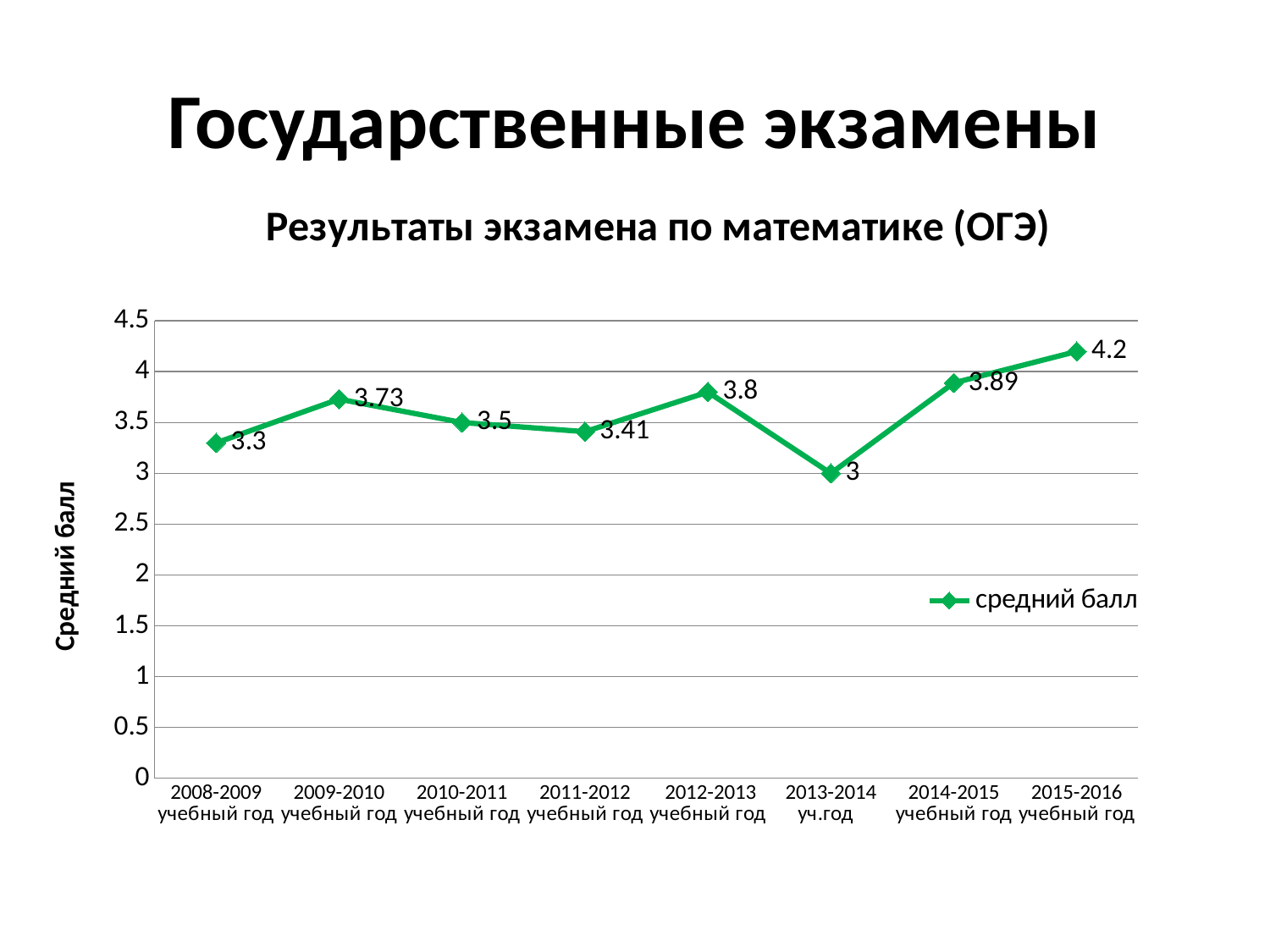
What is the average score for 2013-2014 уч.год? 3 How many series does the legend list? 1 What kind of chart is shown on the slide? line chart Is the value for 2014-2015 учебный год greater or less than 3.5? greater Which is larger: the average score for 2009-2010 учебный год or 2011-2012 учебный год? 2009-2010 учебный год What is the average score for 2015-2016 учебный год? 4.2 What is the title of the chart? Результаты экзамена по математике (ОГЭ) How many academic years are plotted on the chart? 8 Which academic year has the lowest average score? 2013-2014 уч.год What is the difference between the average score for 2015-2016 учебный год and 2008-2009 учебный год? 0.9 What is the average score for 2008-2009 учебный год? 3.3 Which academic year has the highest average score? 2015-2016 учебный год